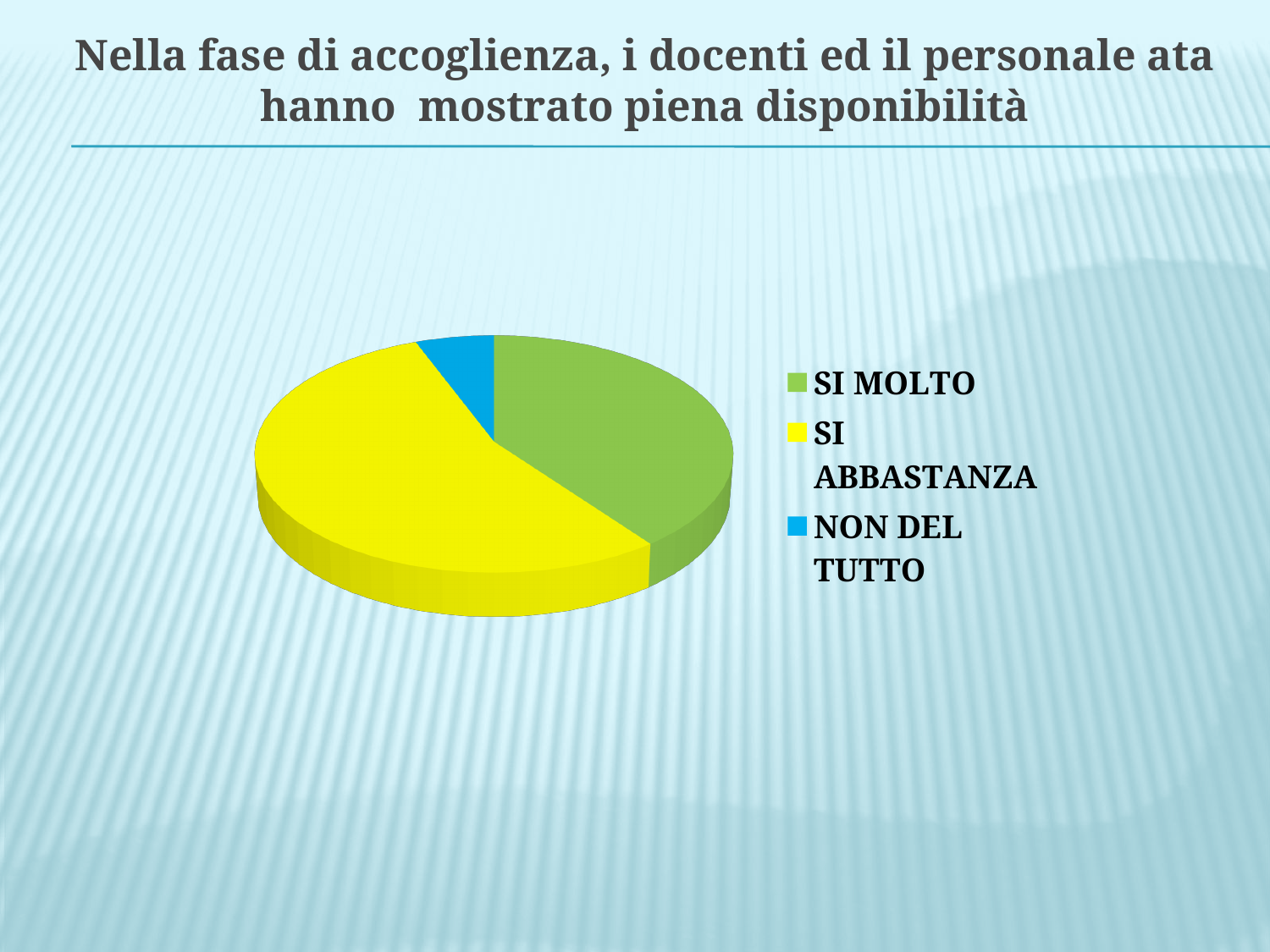
Which slice is larger, SI MOLTO or NON DEL TUTTO? SI MOLTO Which slice is larger, SI MOLTO or SI ABBASTANZA? SI ABBASTANZA What colour is the SI MOLTO slice in the pie chart? green Which category has the largest slice of the pie chart? SI ABBASTANZA Which category is shown in blue in the pie chart? NON DEL TUTTO What kind of chart is shown on the slide? pie chart How many slices does the pie chart have? 3 How many entries does the legend of the pie chart list? 3 Which category has the smallest slice of the pie chart? NON DEL TUTTO Which slice is smaller, SI ABBASTANZA or NON DEL TUTTO? NON DEL TUTTO